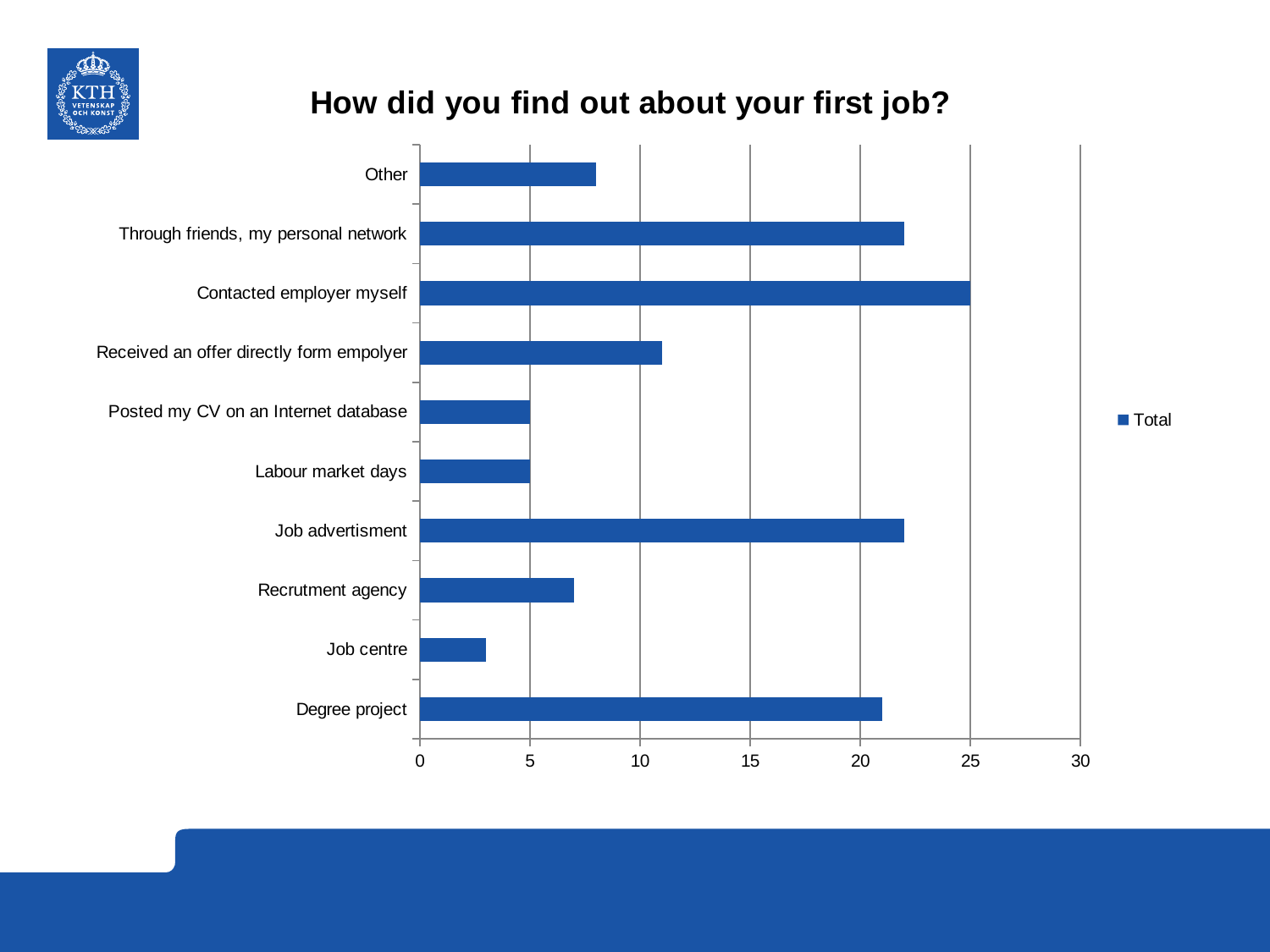
Is the value for Received an offer directly form empolyer greater or less than 15? less Which category has the highest value? Contacted employer myself How many series does the legend list? 1 What is the title of the chart? How did you find out about your first job? Which is larger, the value for Received an offer directly form empolyer or the value for Other? Received an offer directly form empolyer What kind of chart is shown on the slide? bar chart What is the value for Contacted employer myself? 25 Is the value for Other greater or less than 10? less Is the value for Through friends, my personal network greater or less than 20? greater Which category has the lowest value? Job centre What is the value for Labour market days? 5 How many categories are shown on the chart? 10